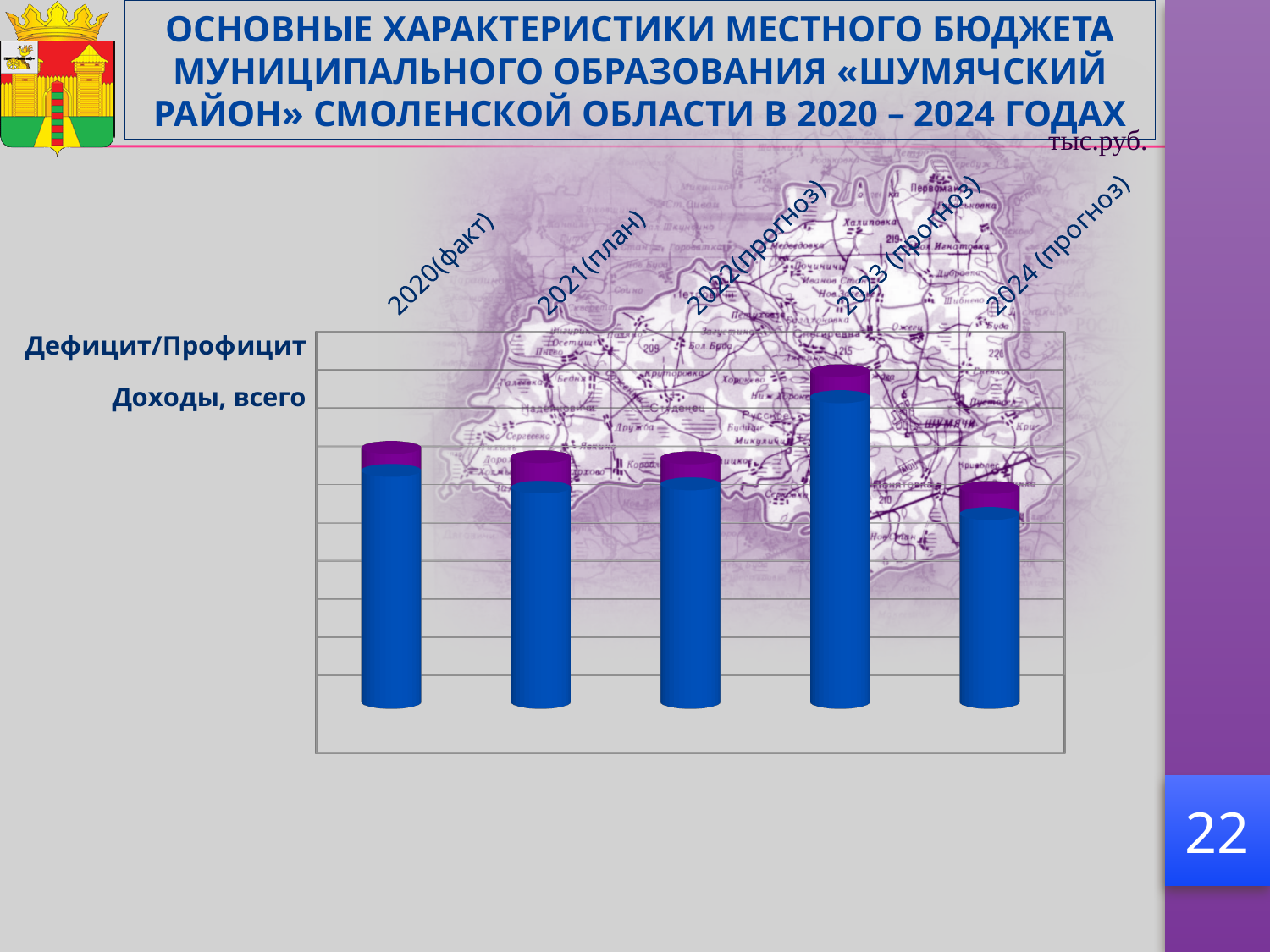
Does the bar height rise or fall from 2023 (прогноз) to 2024 (прогноз)? fall Which series is shown in blue in the chart? Доходы, всего Which bar is taller, 2020(факт) or 2024 (прогноз)? 2020(факт) What kind of chart is shown on the slide? bar chart Which year category has the shortest bar in the chart? 2024 (прогноз) Which year category has the tallest bar in the chart? 2023 (прогноз) How many year categories are shown along the x axis of the chart? 5 Does the bar height rise or fall from 2022(прогноз) to 2023 (прогноз)? rise Which bar is taller, 2022(прогноз) or 2023 (прогноз)? 2023 (прогноз) What unit of measurement is indicated for the chart values? тыс.руб.